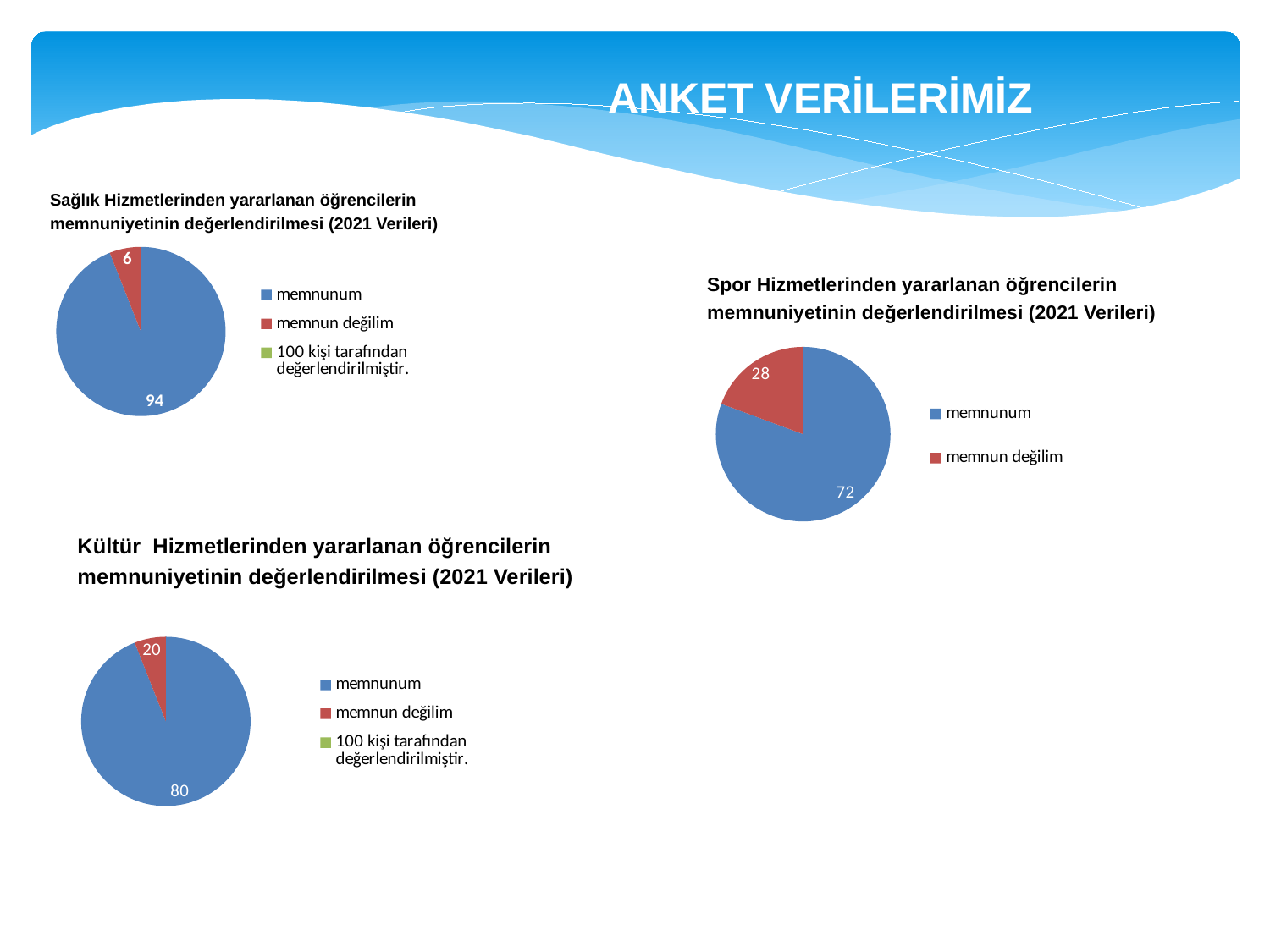
What type of chart is used for the Kültür Hizmetleri data (bottom left)? Pie chart In the Spor Hizmetleri chart (right), what is the value for "memnun değilim"? 28 In the Sağlık Hizmetleri chart (top left), what is the value for "memnunum"? 94 In the Spor Hizmetleri chart (right), what is the difference between the "memnunum" and "memnun değilim" values? 44 In the Kültür Hizmetleri chart (bottom left), what is the value for "memnunum"? 80 In the Kültür Hizmetleri chart (bottom left), what is the value for "memnun değilim"? 20 In the Spor Hizmetleri chart (right), what is the value for "memnunum"? 72 How many entries does the legend of the Spor Hizmetleri chart (right) list? 2 In the Spor Hizmetleri chart (right), which category has the largest slice? memnunum In the Sağlık Hizmetleri chart (top left), what is the value for "memnun değilim"? 6 In the Sağlık Hizmetleri chart (top left), what is the difference between the "memnunum" and "memnun değilim" values? 88